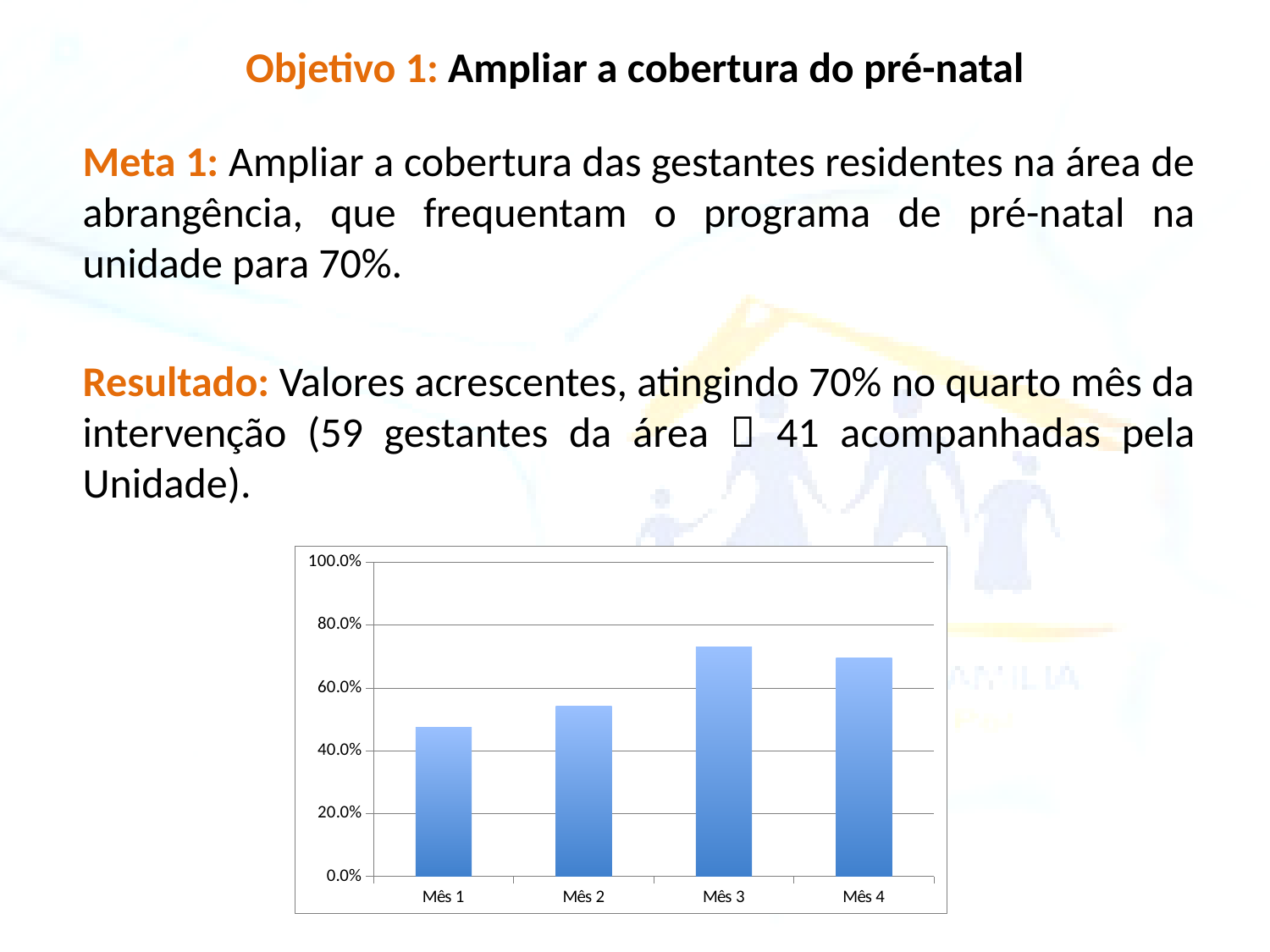
Is the value for Mês 2 greater or less than 40.0%? greater Which is larger, the value for Mês 3 or the value for Mês 4? Mês 3 Is the value for Mês 3 greater or less than 60.0%? greater What is the highest value shown on the y axis of the chart? 100.0% Which is larger, the value for Mês 1 or the value for Mês 2? Mês 2 Which month has the lowest bar in the chart? Mês 1 Do the values rise or fall from Mês 1 to Mês 3? rise What kind of chart is shown on the slide? bar chart Is the value for Mês 1 greater or less than 60.0%? less Which month has the highest bar in the chart? Mês 3 How many categories (months) are plotted on the x axis of the chart? 4